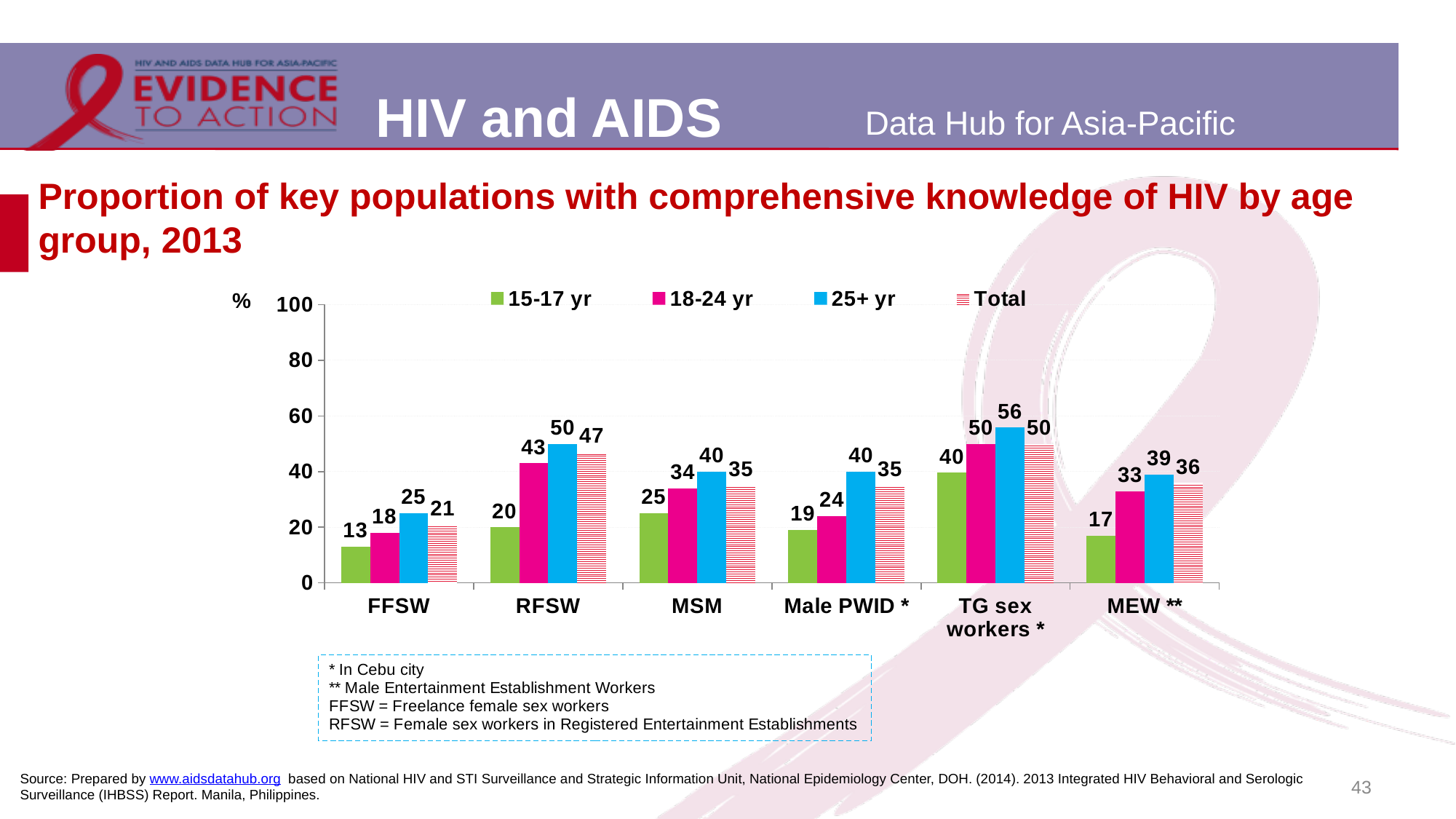
What is the value for the 25+ yr group among RFSW? 50 Which key population has the highest Total value? TG sex workers * Which is larger: the 18-24 yr value for RFSW or the 18-24 yr value for MEW **? RFSW How many key population categories are shown on the x axis? 6 What unit is shown on the y axis label? % What is the difference between the 25+ yr value and the 15-17 yr value for TG sex workers *? 16 Within the FFSW category, do the values rise or fall from the 15-17 yr group to the 25+ yr group? Rise What is the Total value for MSM? 35 What kind of chart is shown on the slide? Bar chart What is the value for the 15-17 yr group among Male PWID *? 19 How many series does the legend list? 4 Which key population has the lowest value for the 15-17 yr group? FFSW